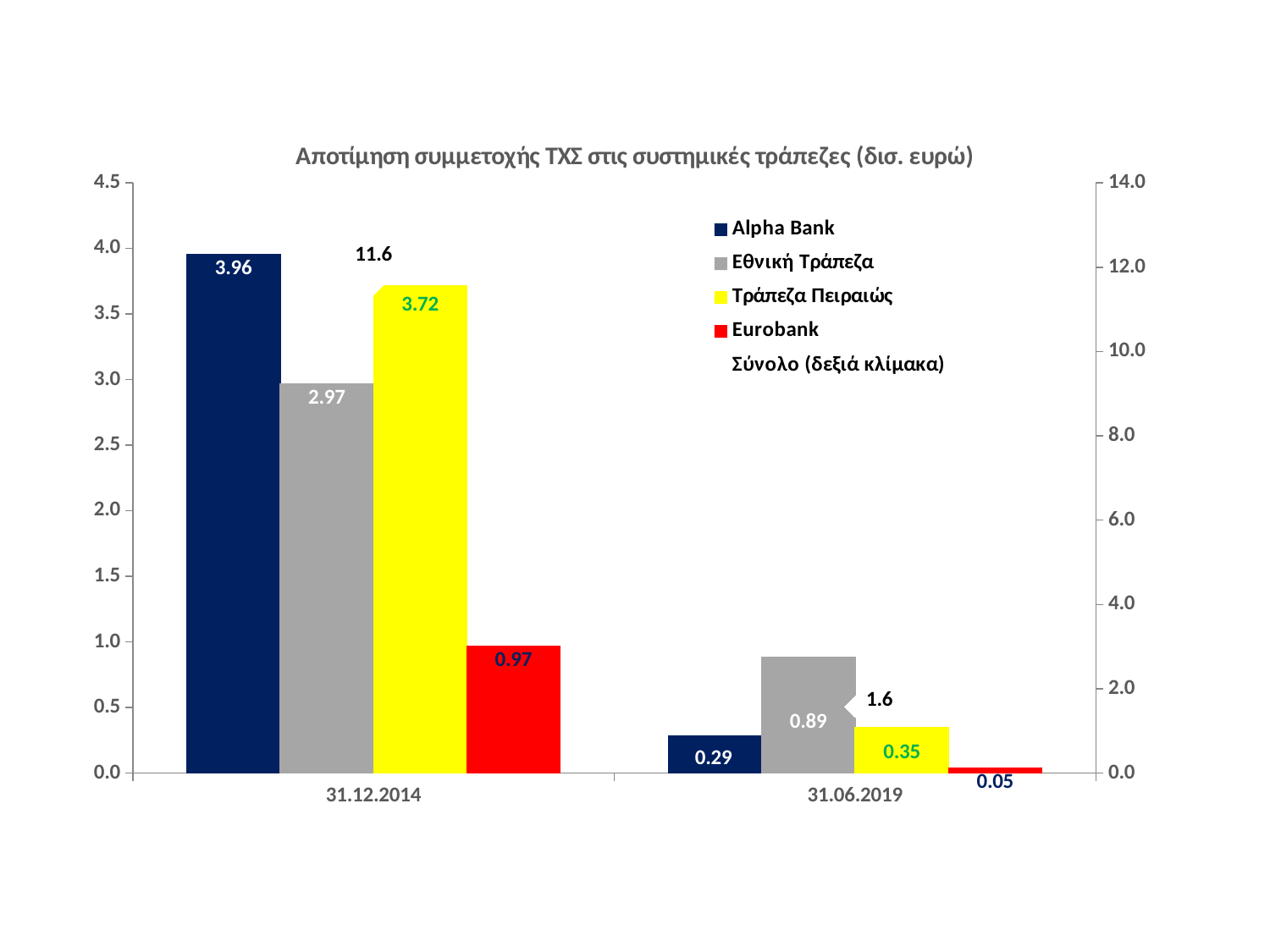
What is the Σύνολο (δεξιά κλίμακα) value at 31.12.2014? 11.6 What colour represents Τράπεζα Πειραιώς in the chart? Yellow What is the value for Alpha Bank at 31.12.2014? 3.96 What kind of chart is this? Bar chart What is the value for Eurobank at 31.12.2014? 0.97 Which is larger at 31.06.2019: Εθνική Τράπεζα or Τράπεζα Πειραιώς? Εθνική Τράπεζα What is the difference between the Alpha Bank value at 31.12.2014 and at 31.06.2019? 3.67 Which bank has the highest value at 31.12.2014? Alpha Bank What is the value for Εθνική Τράπεζα at 31.06.2019? 0.89 How many date categories are shown on the x axis? 2 How many series does the legend list? 5 Which bank has the lowest value at 31.06.2019? Eurobank